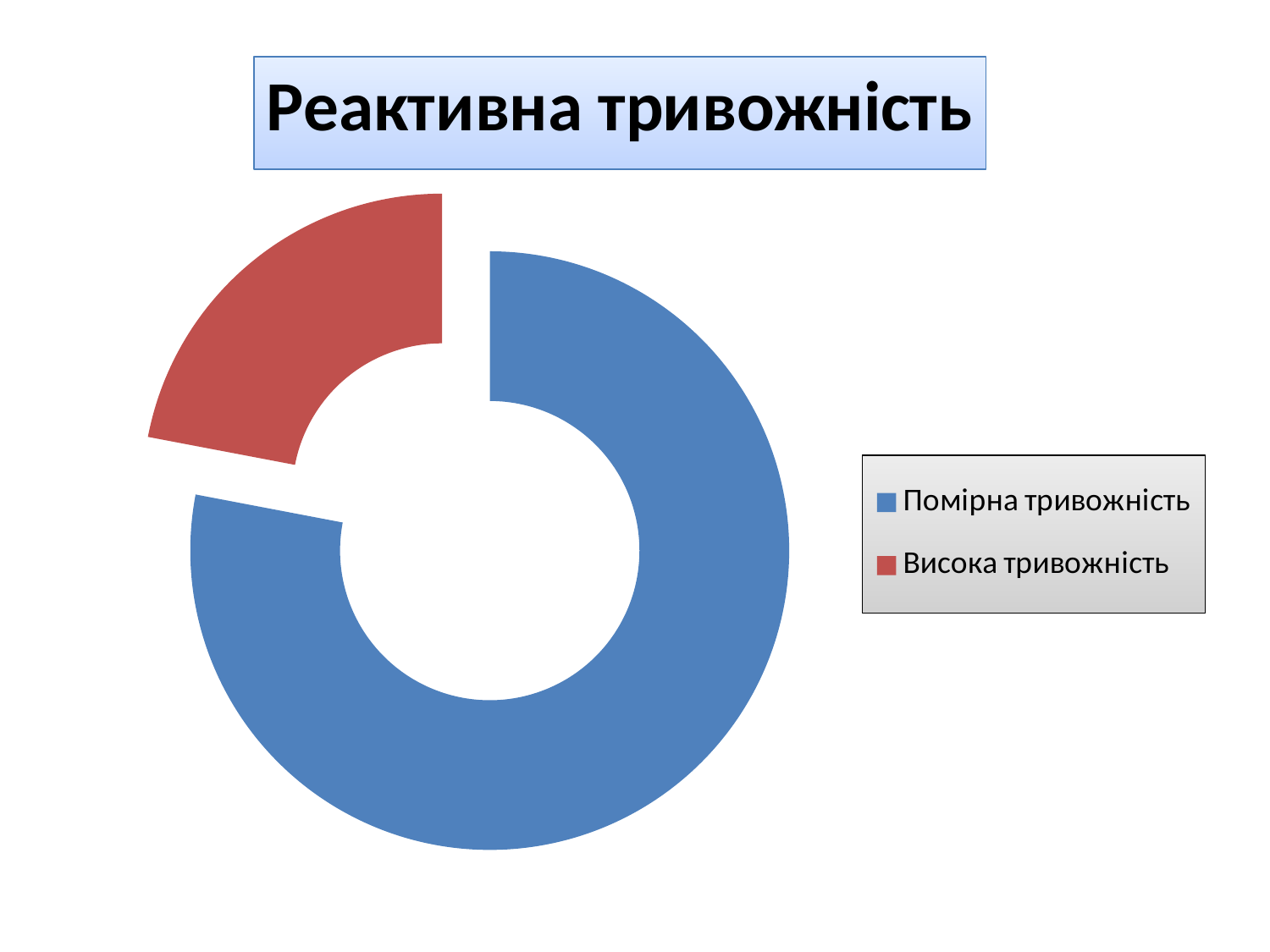
Which is larger: the share for Помірна тривожність or the share for Висока тривожність? Помірна тривожність Is the share for Помірна тривожність greater or less than half of the chart? greater Which category has the largest share of the chart? Помірна тривожність What colour represents Висока тривожність in the chart? Red What kind of chart is shown on the slide? Doughnut chart How many categories does the chart show? 2 Is the share for Висока тривожність greater or less than half of the chart? less What is the title of the chart? Реактивна тривожність Which category has the smallest share of the chart? Висока тривожність How many entries does the legend list? 2